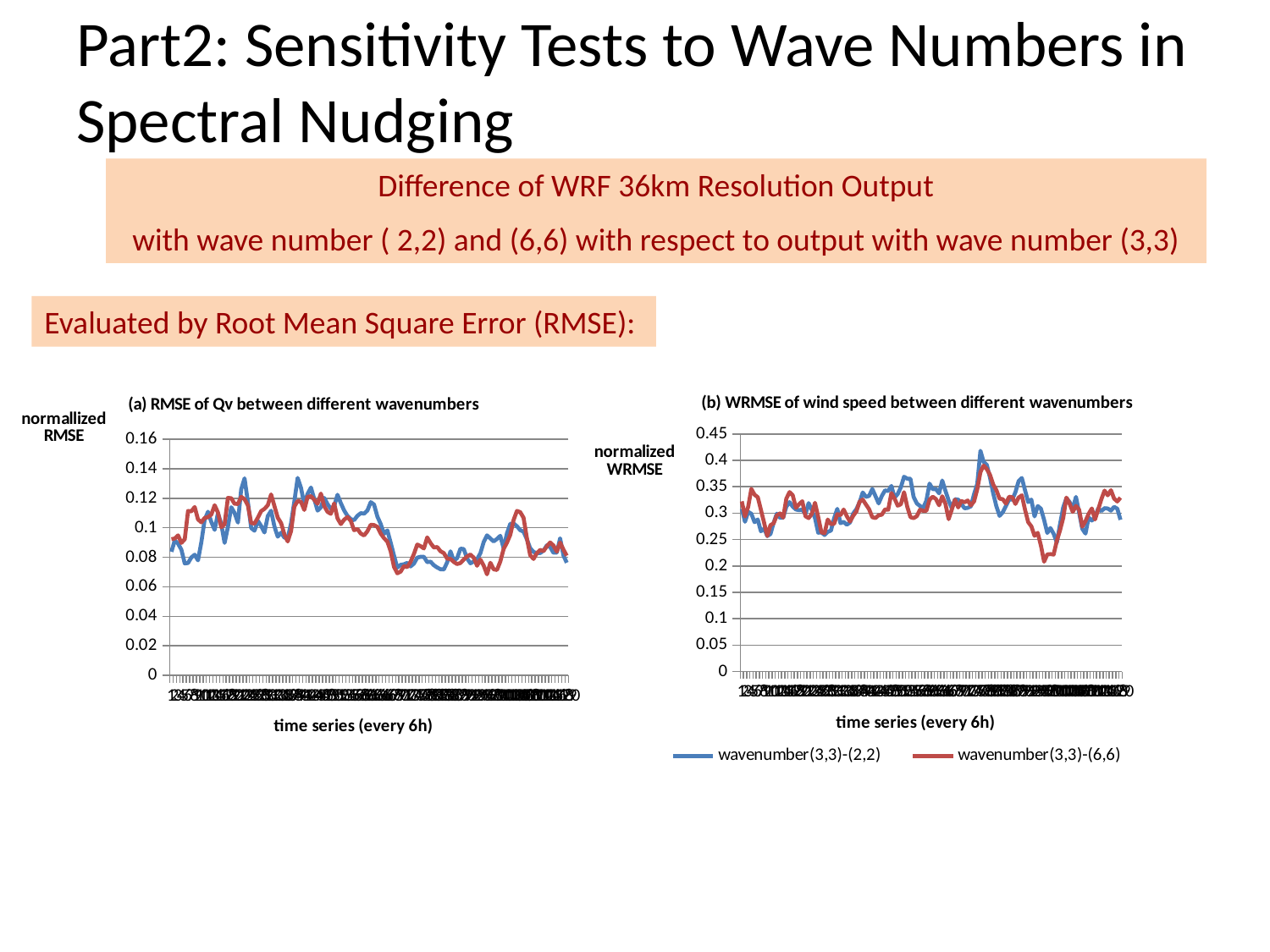
In the chart titled "(a) RMSE of Qv between different wavenumbers", is the lowest value of the red line greater or less than 0.08? less What kind of chart is the chart titled "(b) WRMSE of wind speed between different wavenumbers"? line chart In the chart titled "(a) RMSE of Qv between different wavenumbers", is the highest value of the blue line greater or less than 0.1? greater How many series does the legend list for the chart titled "(b) WRMSE of wind speed between different wavenumbers"? 2 In the chart titled "(b) WRMSE of wind speed between different wavenumbers", is the lowest value of the red wavenumber(3,3)-(6,6) line greater or less than 0.25? less What kind of chart is the chart titled "(a) RMSE of Qv between different wavenumbers"? line chart What is the x-axis label of the chart titled "(a) RMSE of Qv between different wavenumbers"? time series (every 6h) In the chart titled "(b) WRMSE of wind speed between different wavenumbers", which series is drawn in red? wavenumber(3,3)-(6,6)